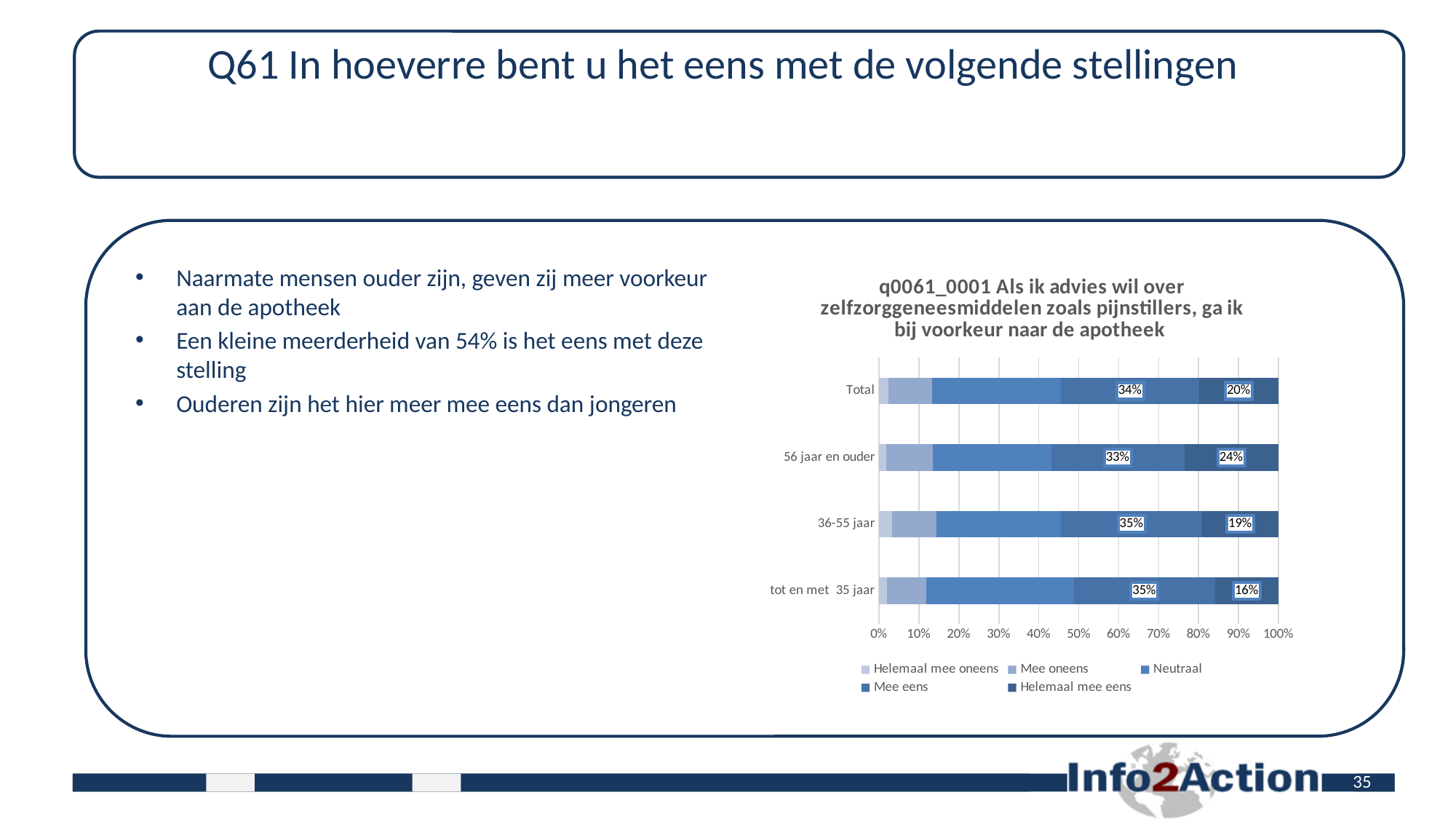
What is the 'Mee eens' value for 36-55 jaar? 35% Which age group has the lowest 'Helemaal mee eens' value? tot en met 35 jaar What is the combined share of 'Mee eens' and 'Helemaal mee eens' for Total? 54% What is the 'Mee eens' value for Total? 34% What is the 'Helemaal mee eens' value for 56 jaar en ouder? 24% What is the difference in 'Helemaal mee eens' between 56 jaar en ouder and tot en met 35 jaar? 8 percentage points What type of chart is shown on the slide? stacked bar chart What is the 'Helemaal mee eens' value for tot en met 35 jaar? 16% Which age group has the highest 'Helemaal mee eens' value? 56 jaar en ouder How many series does the legend list? 5 How many categories (bars) are shown in the chart? 4 Which is larger: the 'Mee eens' value for Total or for 56 jaar en ouder? Total